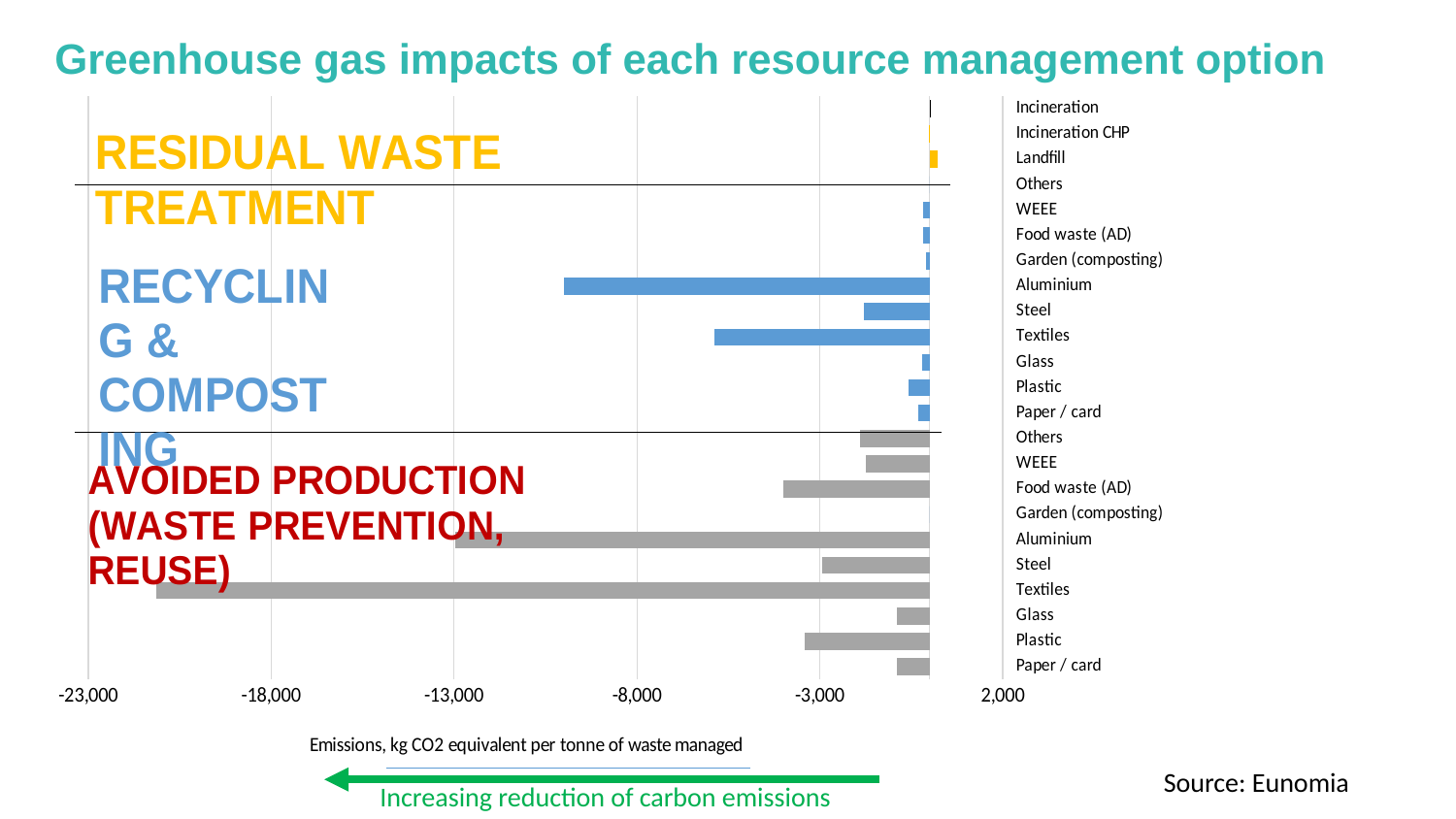
Within the Recycling & Composting group, which bar is longer: Aluminium or Textiles? Aluminium Is the value for Textiles in the Recycling & Composting group greater or less than -8,000? greater How many categories are listed along the right side of the chart? 23 Which category is the only one with a clearly positive (yellow) bar extending to the right of zero? Landfill What is the label of the horizontal axis? Emissions, kg CO2 equivalent per tonne of waste managed Is the value for Aluminium in the Avoided Production group greater or less than -18,000? greater Is the value for Aluminium in the Recycling & Composting group greater or less than -8,000? less What kind of chart is shown on the slide? bar chart Within the Avoided Production group, which bar is longer: Textiles or Aluminium? Textiles What is the source cited for the chart? Eunomia Which category has the longest bar (the largest reduction in emissions)? Textiles (Avoided production)